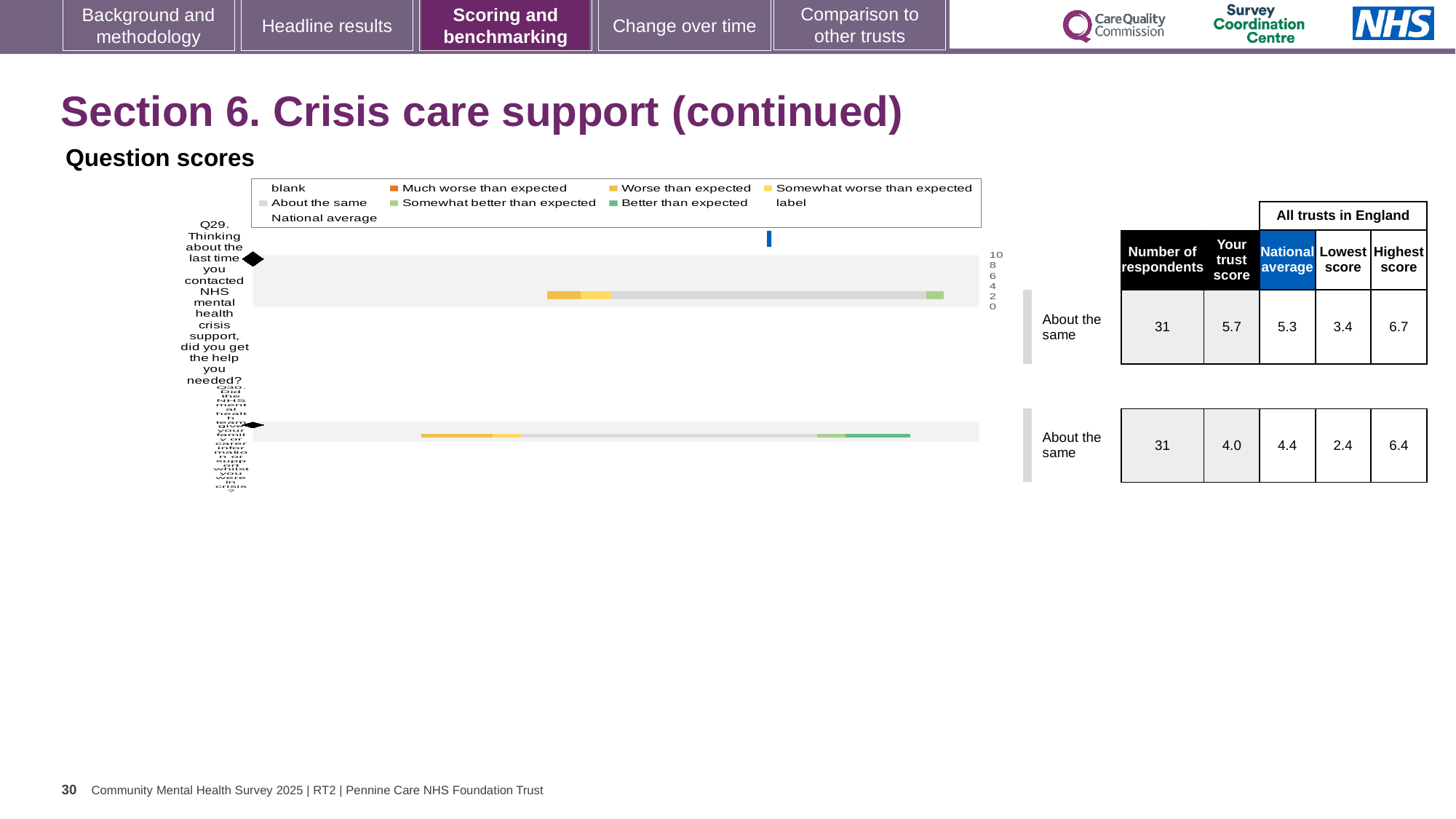
What is the trust score for Q29 (Thinking about the last time you contacted NHS mental health crisis support, did you get the help you needed?)? 5.7 What kind of chart is used to show the question scores on this slide? bar chart How many respondents answered Q30? 31 What benchmarking category is shown for both Q29 and Q30? About the same What is the lowest score among all trusts in England for Q30? 2.4 How many questions are plotted in the question scores chart? 2 What is the trust score for Q30? 4.0 What is the highest score among all trusts in England for Q29? 6.7 What is the difference between the trust score and the national average for Q29? 0.4 Which is larger for Q30, the trust score or the national average? national average Which question has the higher trust score, Q29 or Q30? Q29 What is the national average score for Q29? 5.3